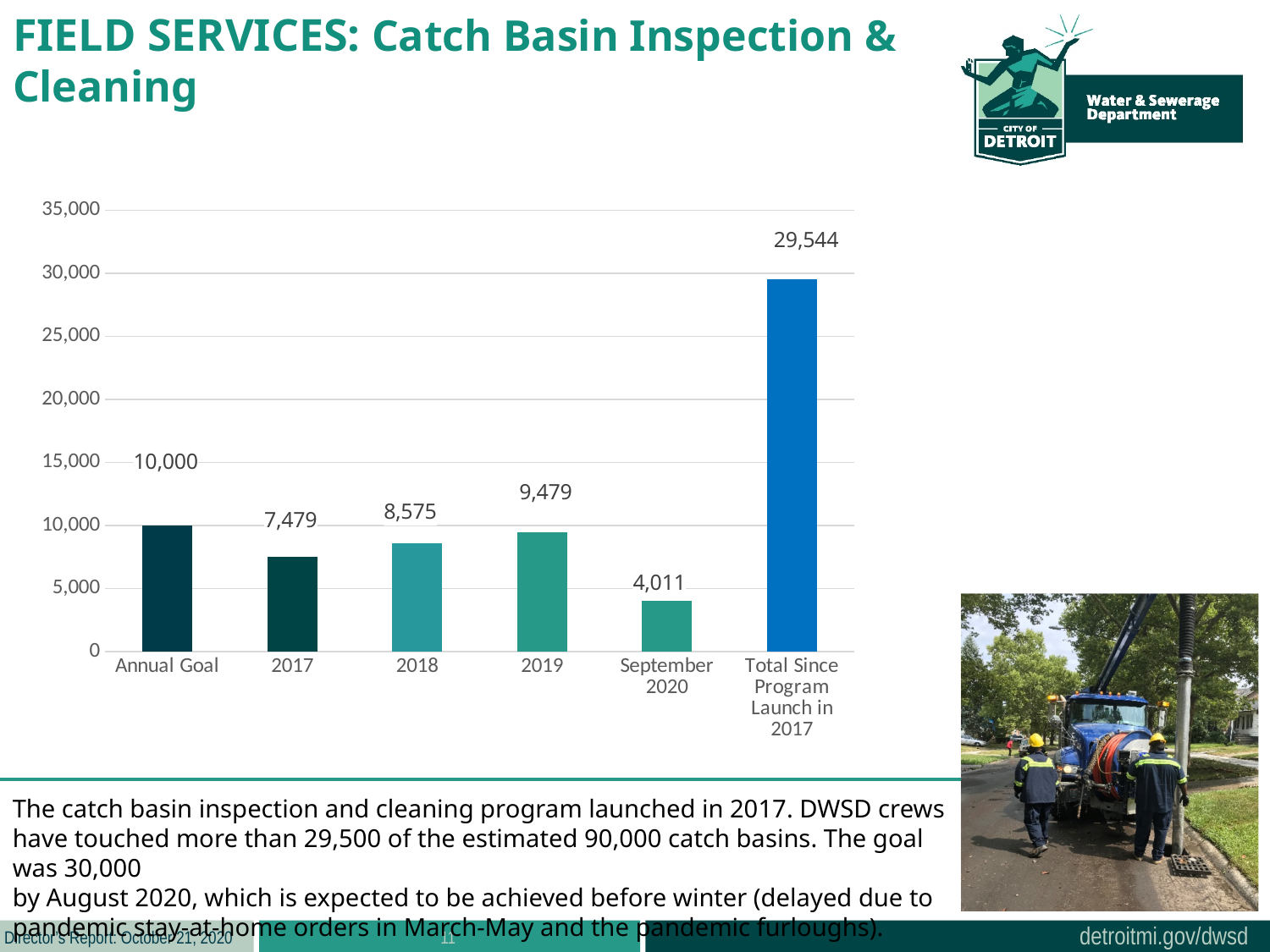
Which category has the highest value? Total Since Program Launch in 2017 What is the difference between the values for 2019 and 2017? 2,000 Do the values rise or fall from 2017 to 2019? Rise How many categories are shown on the x axis? 6 What is the difference between the Annual Goal and the value for 2018? 1,425 Which is larger, the value for 2019 or the value for 2018? 2019 What is the value for 2018? 8,575 What is the value for Annual Goal? 10,000 What is the value for September 2020? 4,011 What kind of chart is shown on the slide? Bar chart Which category has the lowest value? September 2020 What is the value for Total Since Program Launch in 2017? 29,544